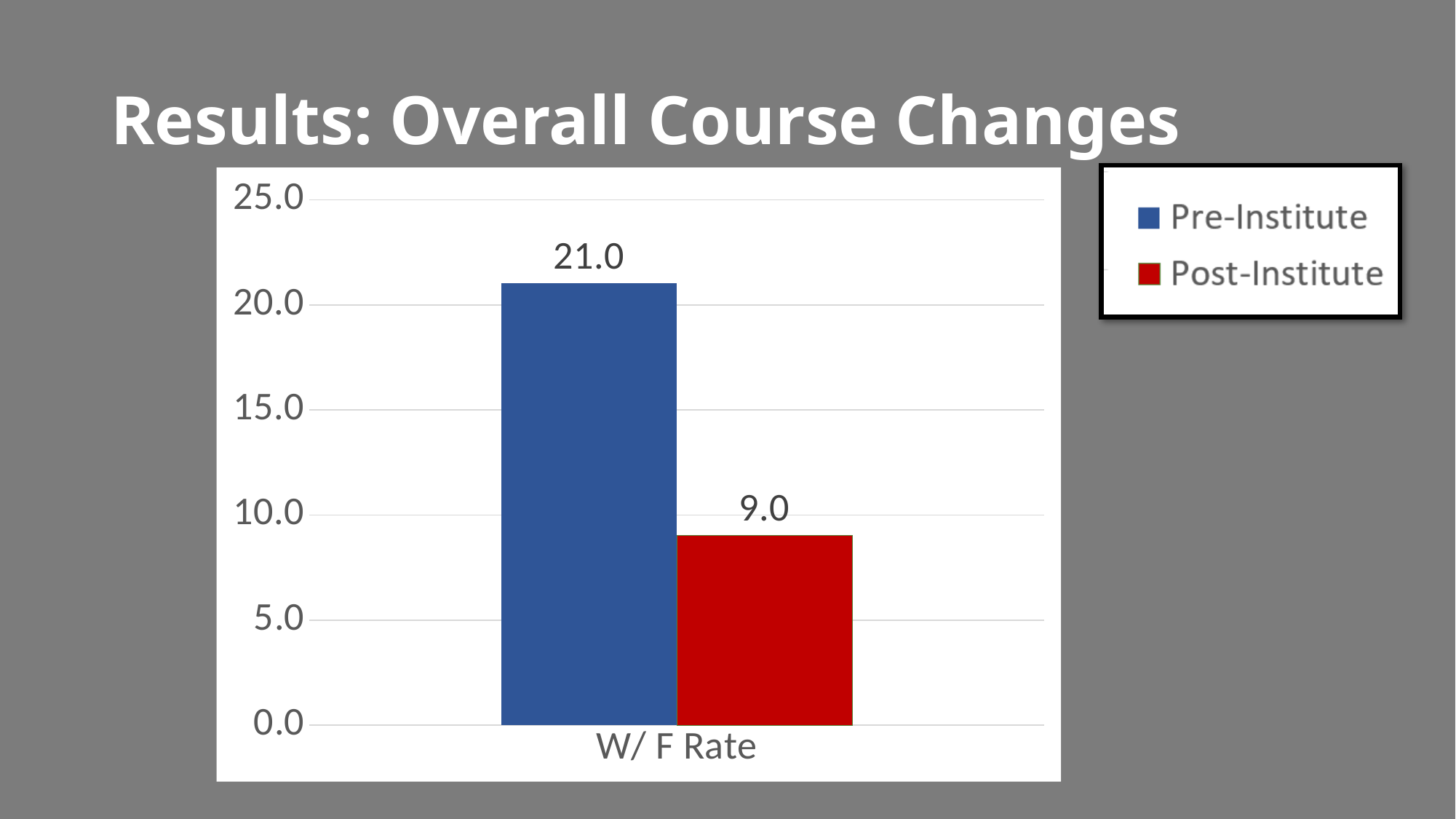
Is the Pre-Institute value for W/ F Rate greater or less than 20.0? greater What is the difference between the Pre-Institute and Post-Institute values for W/ F Rate? 12.0 What is the title of the slide? Results: Overall Course Changes Is the Post-Institute value for W/ F Rate greater or less than 10.0? less What is the Post-Institute value for W/ F Rate? 9.0 How many categories are shown on the x axis? 1 Which series has the lowest value on the chart? Post-Institute What is the Pre-Institute value for W/ F Rate? 21.0 Which series has the higher value for W/ F Rate, Pre-Institute or Post-Institute? Pre-Institute How many series does the legend list? 2 What colour is the Post-Institute bar? Red What kind of chart is shown on the slide? Bar chart